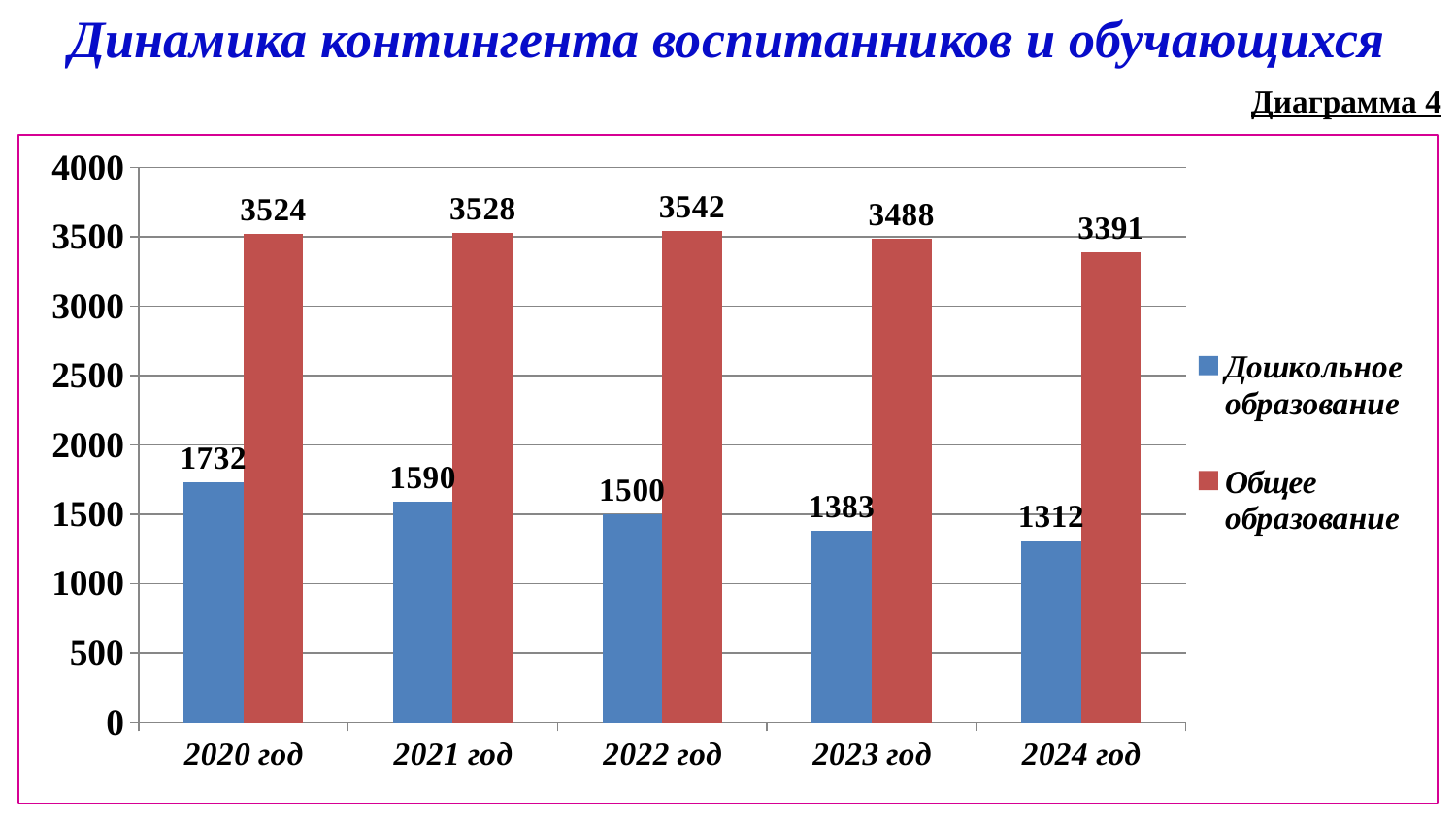
How many years are shown on the x axis? 5 In which year is the value for Дошкольное образование lowest? 2024 год Do the values for Дошкольное образование rise or fall from 2020 год to 2024 год? fall What kind of chart is shown on the slide? bar chart In which year is the value for Общее образование highest? 2022 год What is the value for Общее образование in 2024 год? 3391 How many series does the legend list? 2 What is the difference between Дошкольное образование in 2020 год and in 2024 год? 420 What is the value for Дошкольное образование in 2020 год? 1732 Which is larger: Дошкольное образование in 2021 год or in 2022 год? 2021 год What is the difference between Общее образование and Дошкольное образование in 2023 год? 2105 What is the value for Общее образование in 2022 год? 3542